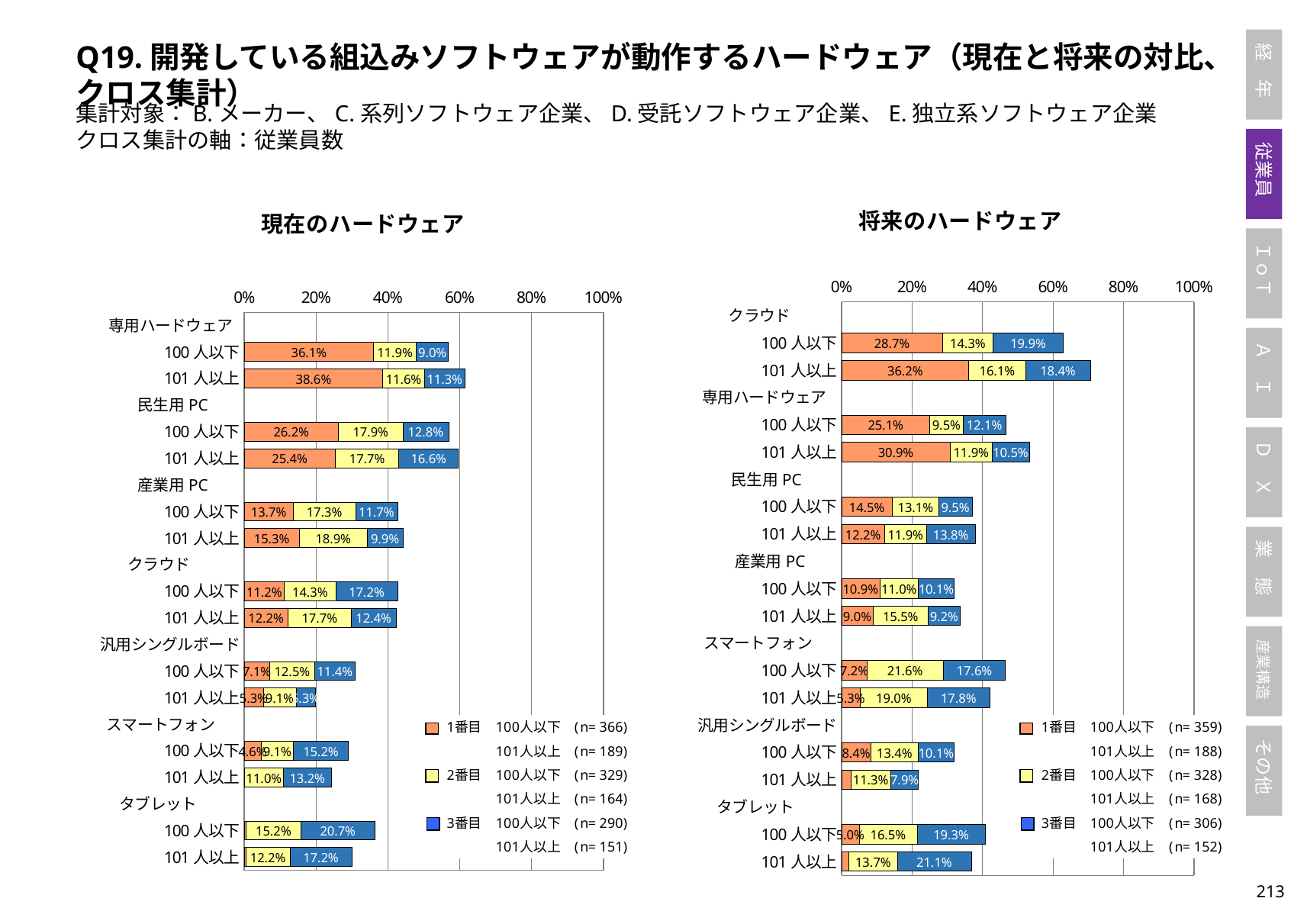
In the 将来のハードウェア chart, what is the 3番目 value for クラウド, 100 人以下? 19.9% In the 現在のハードウェア chart, which row has the highest 1番目 value? 専用ハードウェア, 101 人以上 In the 現在のハードウェア chart, what is the difference between the 1番目 values for 専用ハードウェア, 101 人以上 and 民生用 PC, 101 人以上? 13.2 percentage points How many series does the legend of the 現在のハードウェア chart list? 3 In the 将来のハードウェア chart, what is the total of the stacked bar for クラウド, 101 人以上? 70.7% In the 将来のハードウェア chart, which row has the highest 1番目 value? クラウド, 101 人以上 What kind of chart is the 将来のハードウェア chart? Stacked bar chart In the 将来のハードウェア chart, what is the 2番目 value for スマートフォン, 100 人以下? 21.6% In the 現在のハードウェア chart, what is the total of the stacked bar for 専用ハードウェア, 101 人以上? 61.5% In the 現在のハードウェア chart, what is the 2番目 value for 産業用 PC, 101 人以上? 18.9% In the 将来のハードウェア chart, which is larger: the 1番目 value for クラウド, 100 人以下 or the 1番目 value for 専用ハードウェア, 100 人以下? クラウド, 100 人以下 In the 現在のハードウェア chart, what is the 1番目 value for 専用ハードウェア, 101 人以上? 38.6%